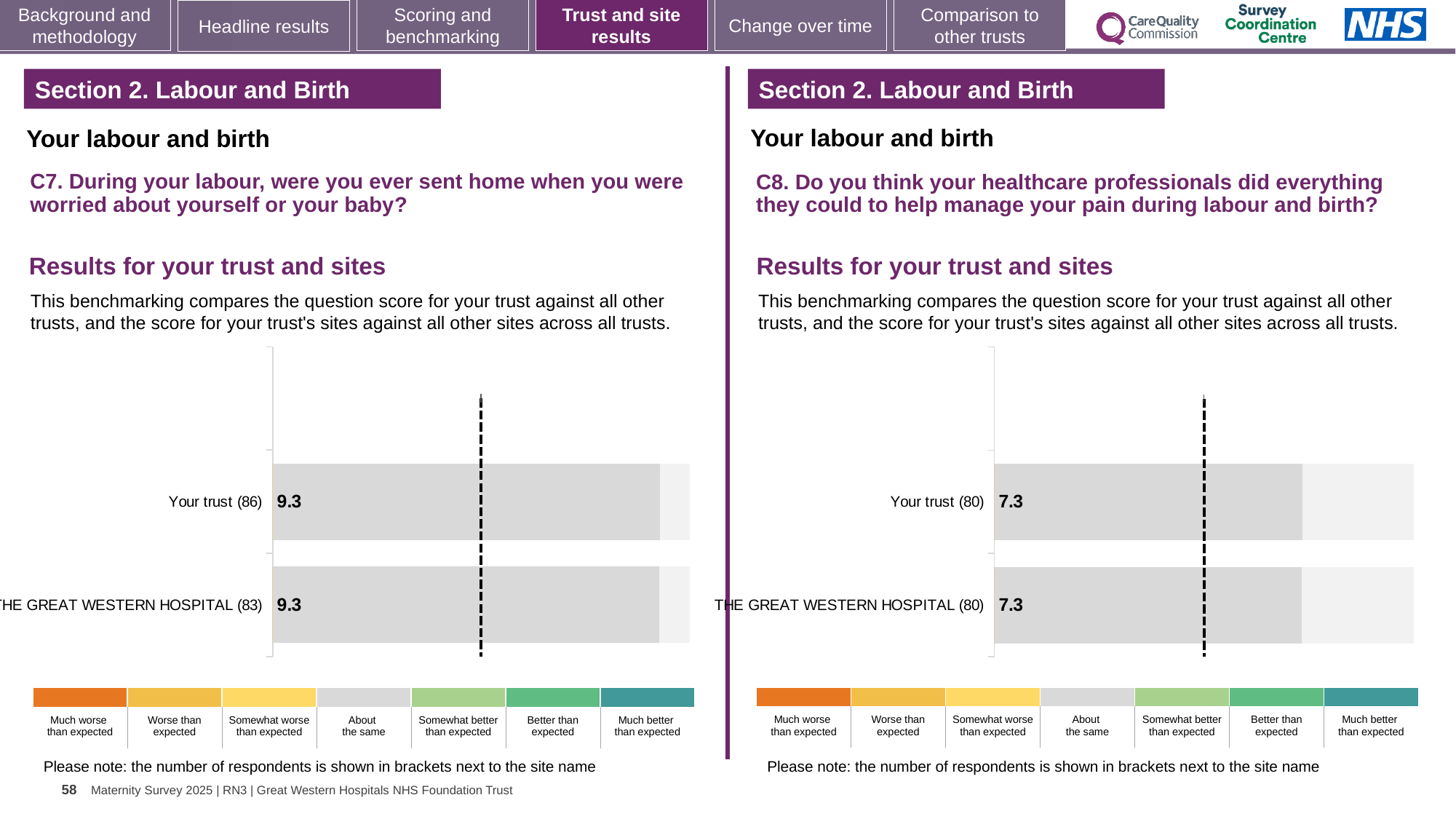
On the right chart (C8), what is the difference between the score for Your trust and the score for THE GREAT WESTERN HOSPITAL? 0 How many bars are plotted on the right chart (C8)? 2 On the right chart (C8), how many respondents are shown in brackets next to Your trust? 80 On the right chart (C8), what is the score shown for Your trust? 7.3 What type of chart is used on the left (C7) to show the results for your trust and sites? Bar chart On the left chart (C7), what is the score shown for Your trust? 9.3 On the left chart (C7), how many respondents are shown in brackets next to THE GREAT WESTERN HOSPITAL? 83 On the left chart (C7), what is the difference between the score for Your trust and the score for THE GREAT WESTERN HOSPITAL? 0 On the left chart (C7), what is the score shown for THE GREAT WESTERN HOSPITAL? 9.3 On the right chart (C8), what is the score shown for THE GREAT WESTERN HOSPITAL? 7.3 How many bars are plotted on the left chart (C7)? 2 Which category does the colour legend below each chart label as the middle band? About the same